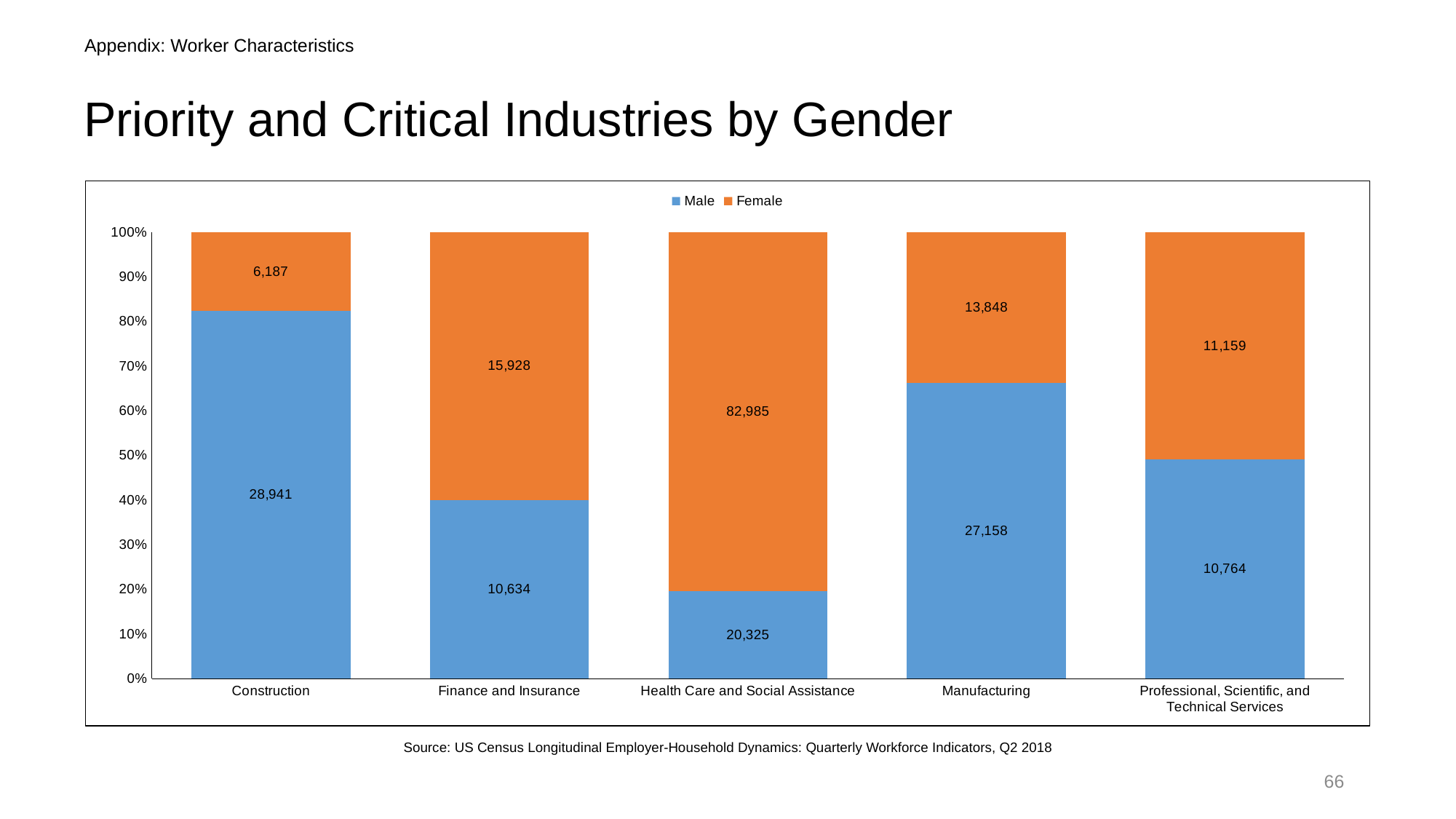
What is the Female value for Health Care and Social Assistance? 82,985 How many series does the legend list? 2 Which industry has the lowest Female value? Construction Which is larger for Finance and Insurance, the Male value or the Female value? Female Which industry has the highest Female value? Health Care and Social Assistance What is the Female value for Manufacturing? 13,848 What is the difference between the Female and Male values for Health Care and Social Assistance? 62,660 What is the total of the Male and Female values for Construction? 35,128 Is the Male share of the Manufacturing bar greater or less than 60%? greater How many industries are shown on the x axis? 5 What is the Male value for Professional, Scientific, and Technical Services? 10,764 What is the Male value for Construction? 28,941